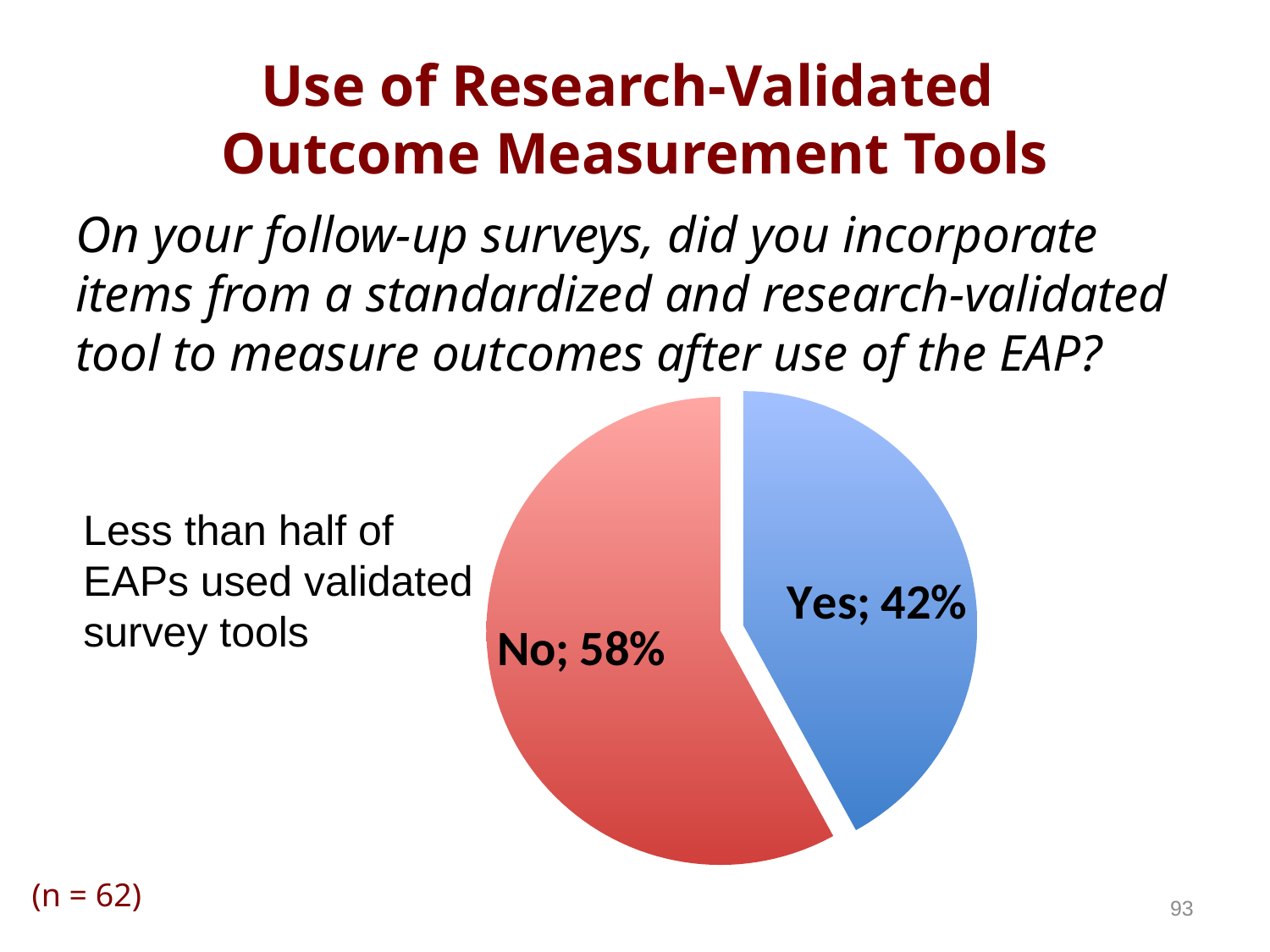
What is the sample size (n) shown on the slide? 62 Which response has the smallest share of the pie? Yes What percentage of respondents answered "No"? 58% What colour is the "No" slice? red Which slice is larger, "Yes" or "No"? No Which response has the largest share of the pie? No What share of the pie does the "No" slice represent? 58% What is the difference in percentage points between the "No" and "Yes" slices? 16 What percentage of respondents answered "Yes"? 42% How many slices does the pie chart have? 2 What colour is the "Yes" slice? blue What kind of chart is shown on the slide? pie chart